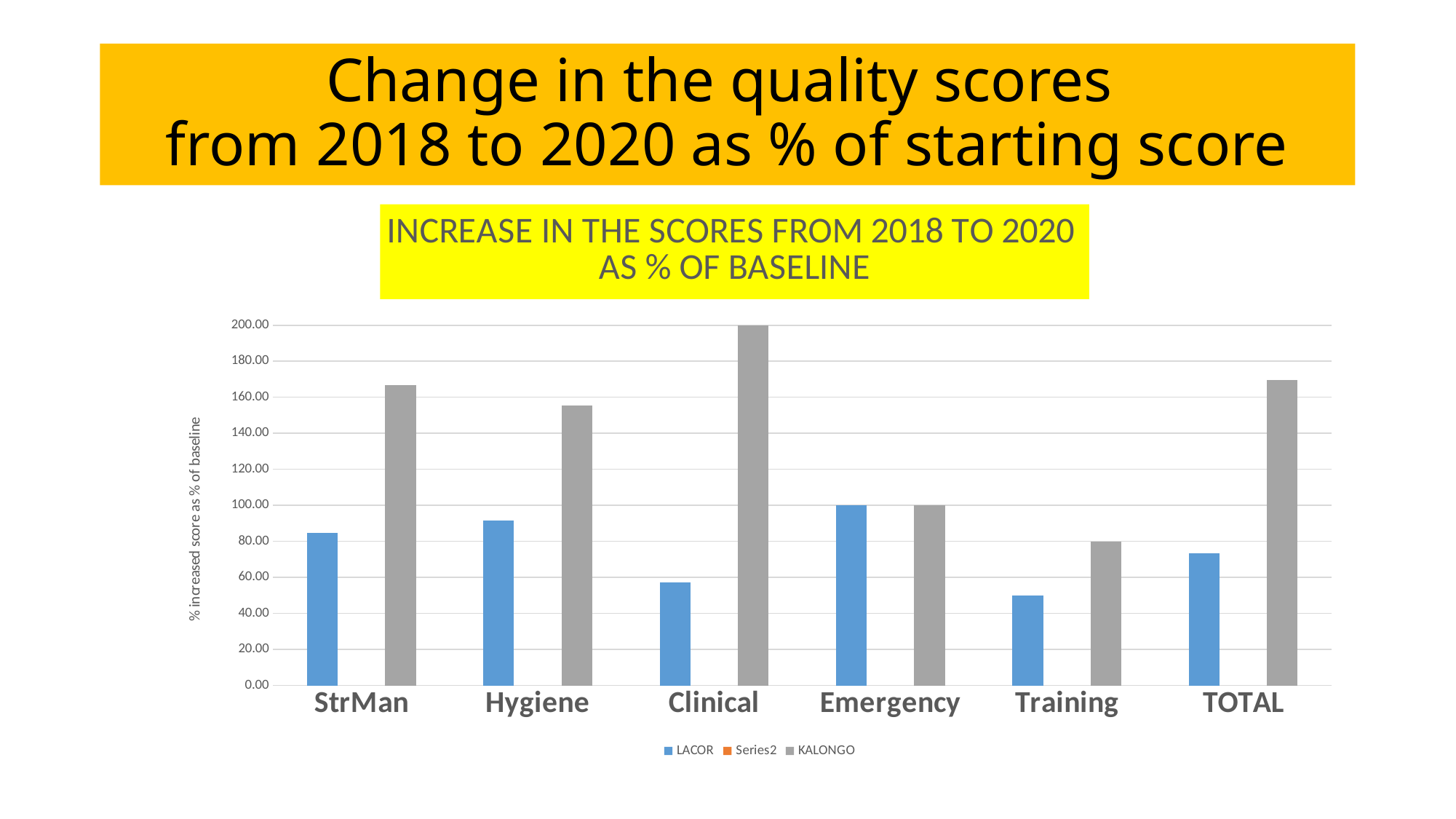
What is the KALONGO value for Clinical? 200.00 Which category has the highest KALONGO value? Clinical Is the LACOR value for Hygiene greater or less than 80.00? greater For StrMan, which is larger: the LACOR value or the KALONGO value? KALONGO How many series does the chart's legend list? 3 Which category has the lowest KALONGO value? Training What kind of chart is shown on the slide? bar chart What is the LACOR value for Emergency? 100.00 Which category has the lowest LACOR value? Training How many categories are shown on the x axis of the chart? 6 What is the label of the vertical axis of the chart? % increased score as % of baseline What is the KALONGO value for Training? 80.00